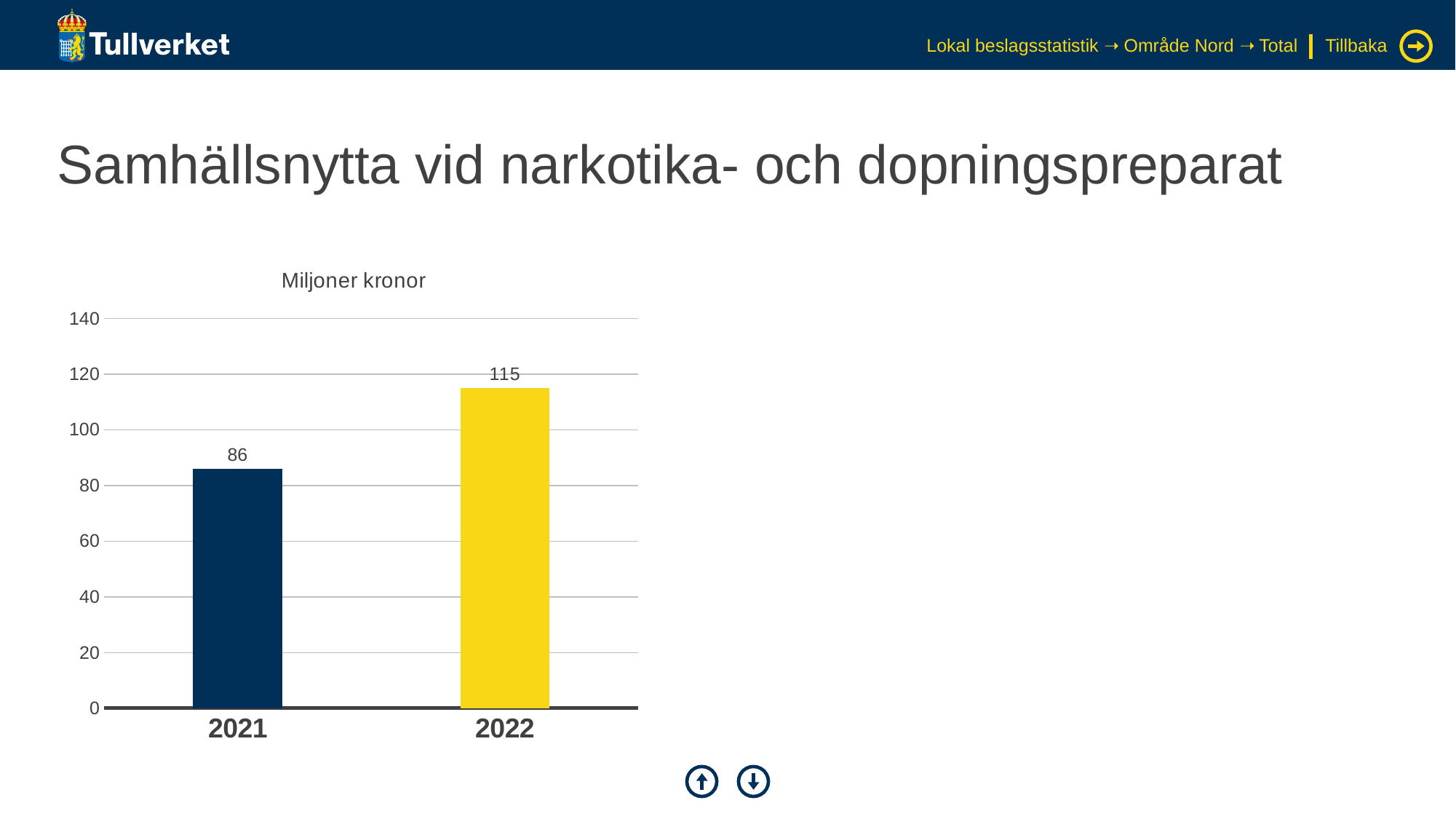
What is the difference between the values for 2022 and 2021? 29 What kind of chart is shown on the slide? bar chart What is the value for 2022? 115 Which is larger, the value for 2021 or the value for 2022? 2022 What unit is shown above the chart's y axis? Miljoner kronor Is the value for 2021 greater or less than 100? less Do the values rise or fall from 2021 to 2022? rise What is the value for 2021? 86 Is the value for 2022 greater or less than 100? greater Which year has the highest value? 2022 Which year has the lowest value? 2021 How many years are shown on the chart? 2